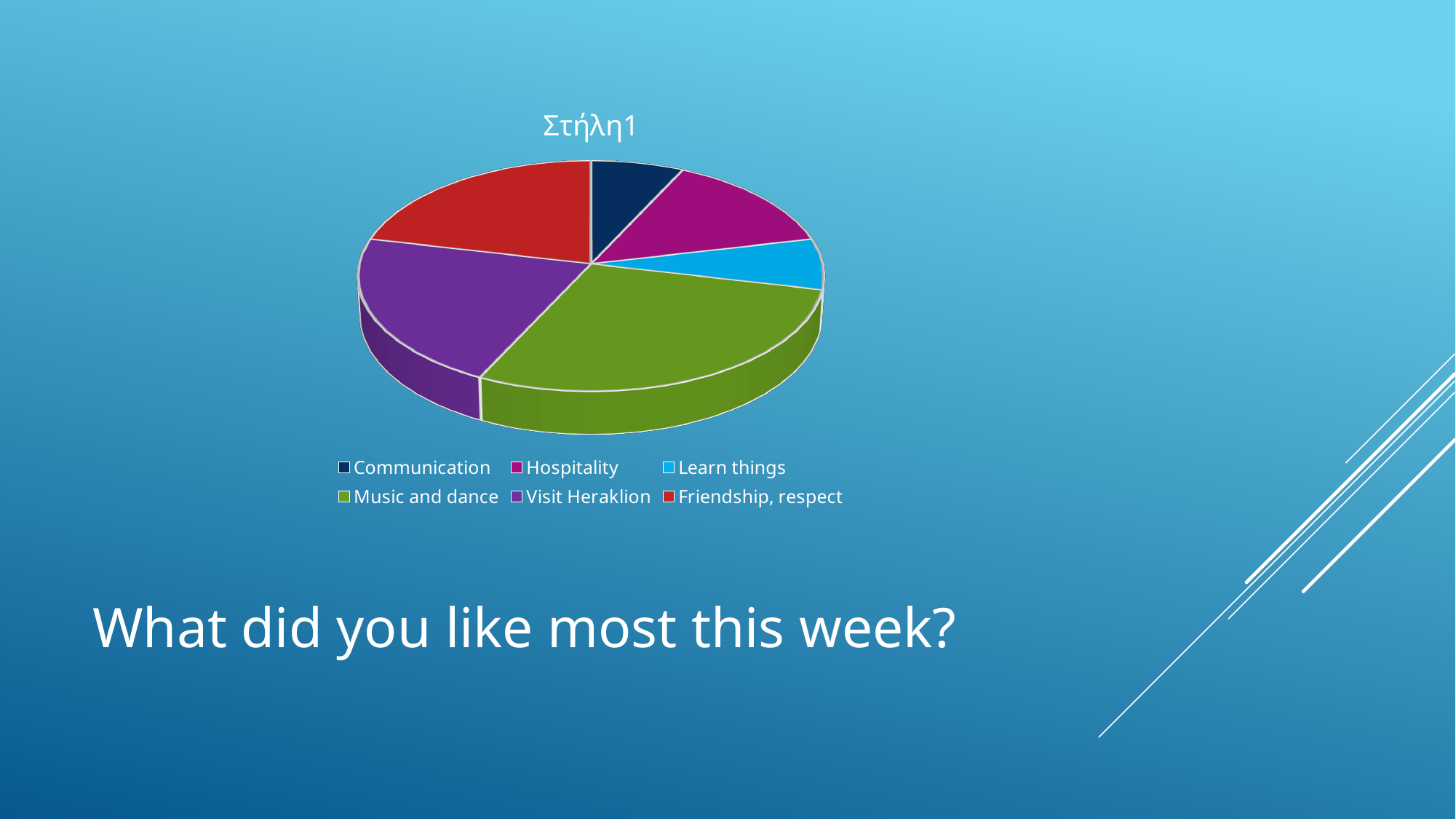
Which category has the largest slice of the pie chart? Music and dance Which slice is larger, Friendship, respect or Learn things? Friendship, respect How many categories does the pie chart show? 6 What kind of chart is shown on the slide? Pie chart Which slice is larger, Music and dance or Communication? Music and dance What is the title of the pie chart? Στήλη1 Which slice is larger, Visit Heraklion or Hospitality? Visit Heraklion Which category is shown in green on the pie chart? Music and dance